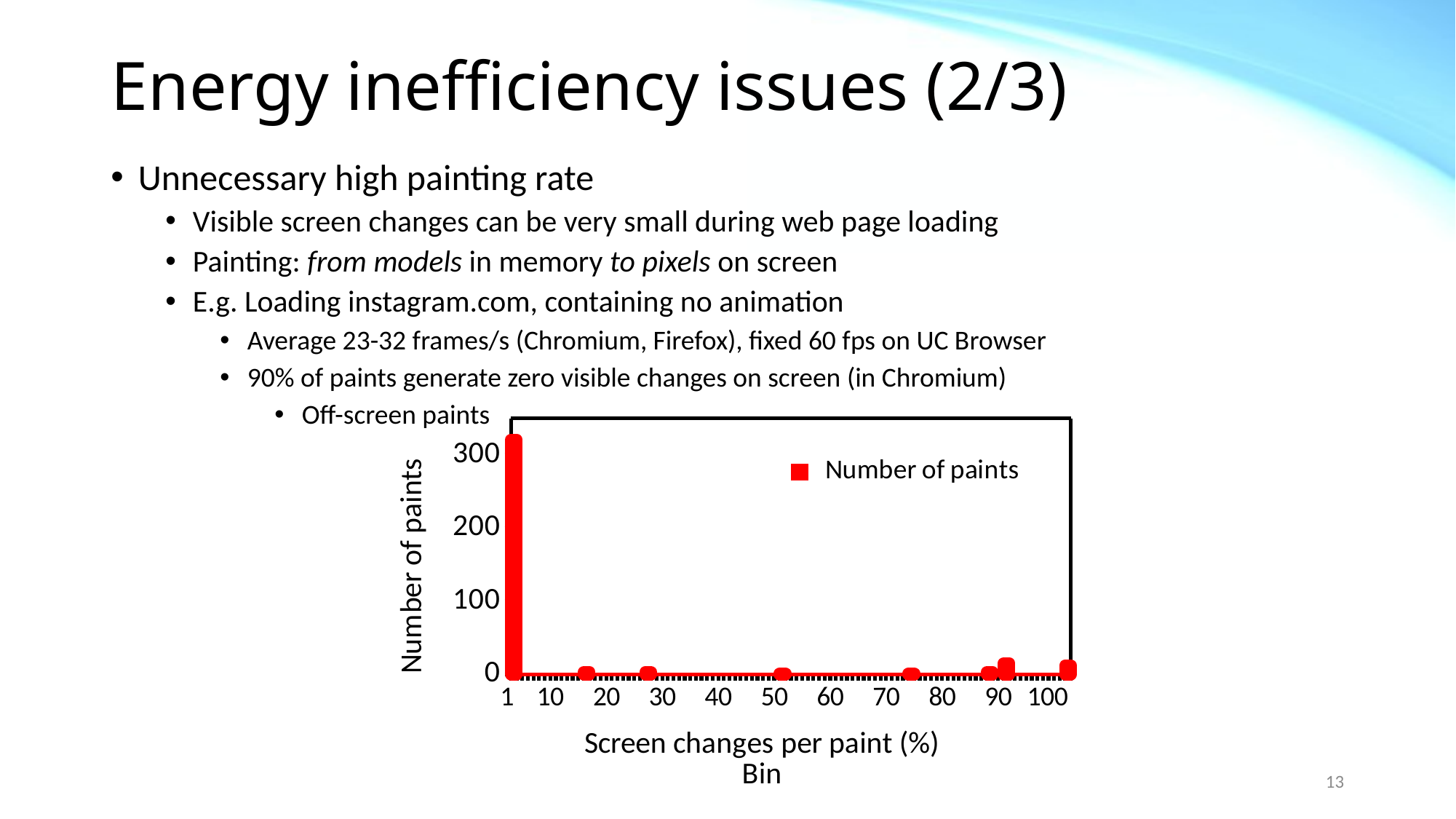
Which has a larger number of paints, bin 1 or bin 100? bin 1 Is the number of paints for bin 50 greater or less than 100? less How many series does the chart legend list? 1 Is the number of paints for bin 100 greater or less than 100? less What kind of chart is shown on the slide? bar chart Is the number of paints for bin 1 greater or less than 300? greater What is the legend entry shown in the chart? Number of paints What is the title of the chart's y axis? Number of paints Which has a larger number of paints, bin 1 or bin 50? bin 1 Which bin has the highest number of paints? 1